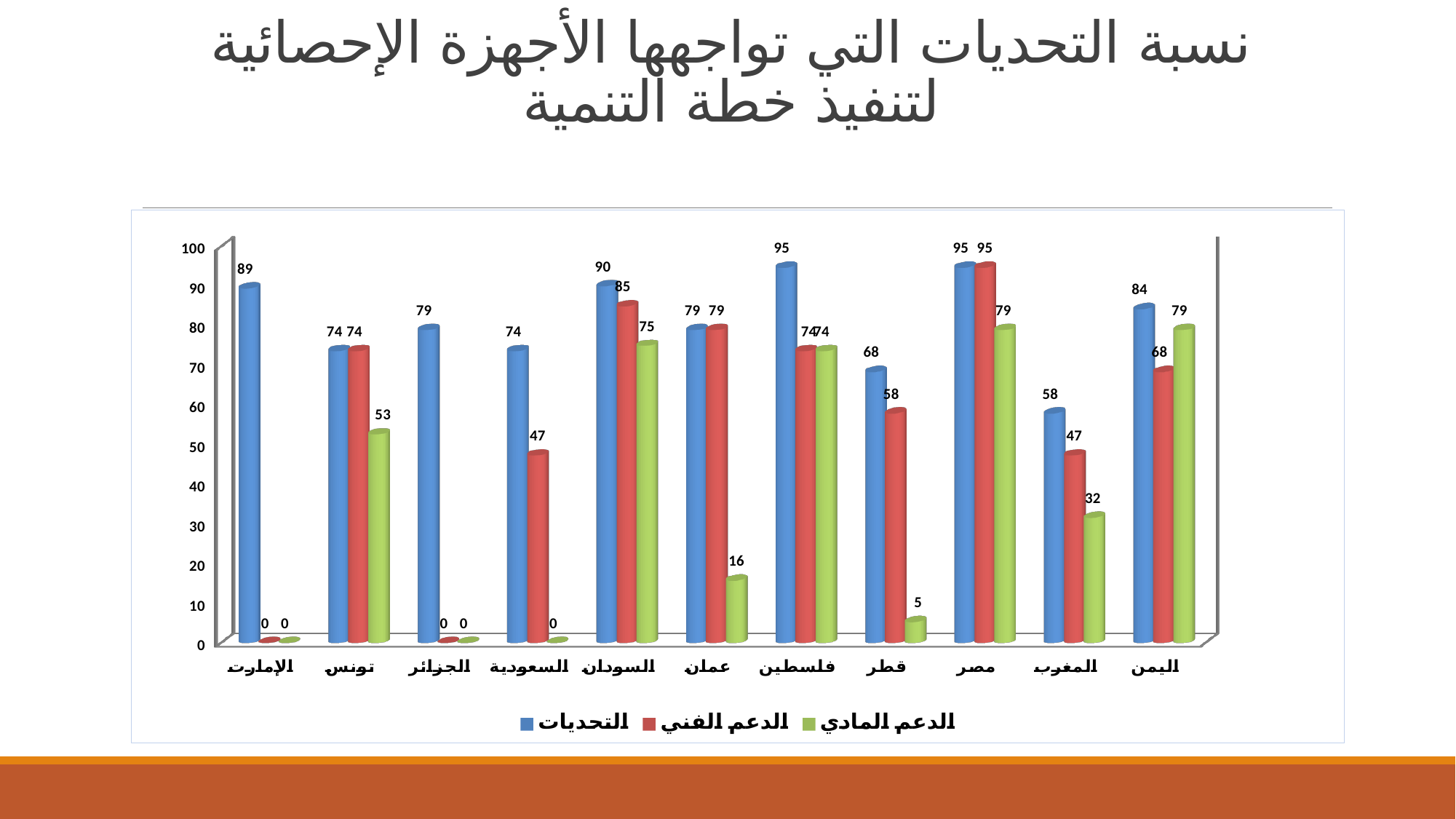
What is the difference between التحديات and الدعم الفني for قطر? 10 What is the value of الدعم الفني for السعودية? 47 Which country has the highest value for الدعم الفني? مصر How many countries are shown on the x axis? 11 What is the value of الدعم المادي for قطر? 5 How many series does the legend list? 3 What is the value of الدعم المادي for عمان? 16 What is the value of التحديات for السودان? 90 Which colour represents الدعم المادي in the legend? green Which country has the lowest value for التحديات? المغرب What kind of chart is shown on the slide? bar chart Which is larger for اليمن: الدعم الفني or الدعم المادي? الدعم المادي